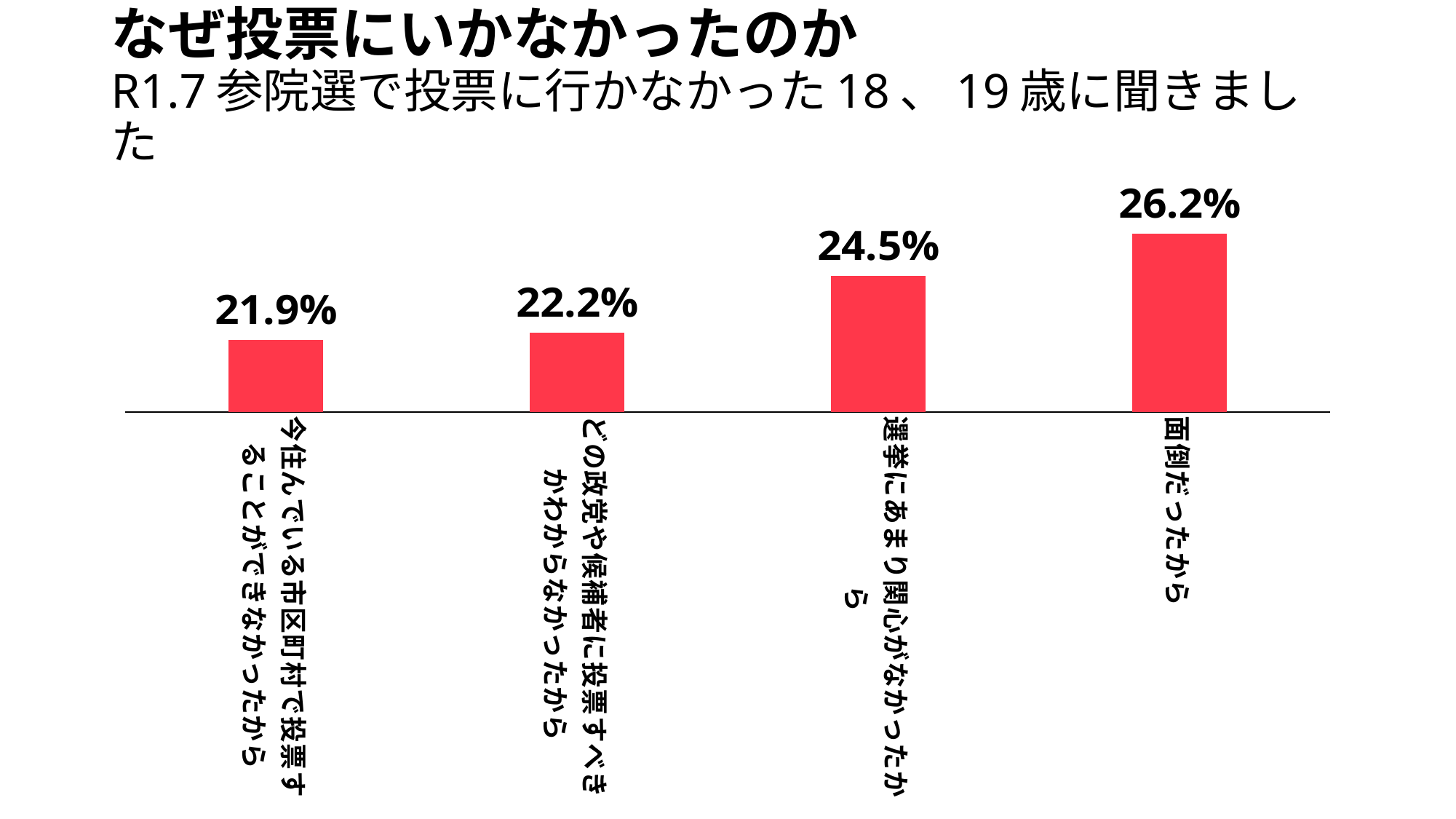
How many categories are shown in the chart? 4 What is the value for どの政党や候補者に投票すべきかわからなかったから? 22.2% What is the value for 今住んでいる市区町村で投票することができなかったから? 21.9% Do the values rise or fall from left to right along the x axis? rise What is the difference between the values for 選挙にあまり関心がなかったから and どの政党や候補者に投票すべきかわからなかったから? 2.3% What is the value for 面倒だったから? 26.2% What kind of chart is shown on the slide? bar chart Which category has the highest value? 面倒だったから Which category has the lowest value? 今住んでいる市区町村で投票することができなかったから What is the value for 選挙にあまり関心がなかったから? 24.5% Which is larger, the value for 面倒だったから or the value for 選挙にあまり関心がなかったから? 面倒だったから What is the difference between the values for 面倒だったから and 今住んでいる市区町村で投票することができなかったから? 4.3%